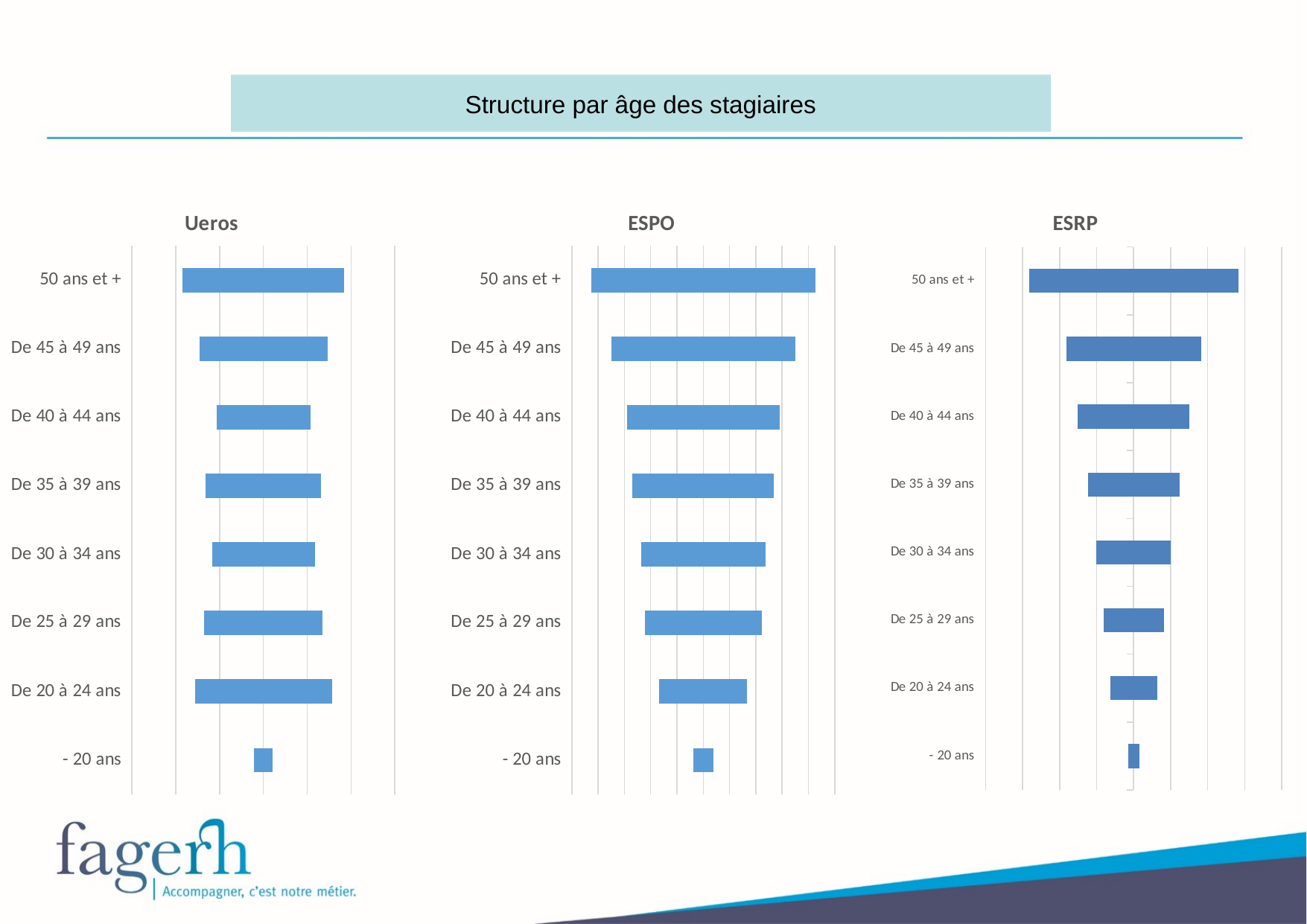
In the ESRP chart, do the bars get longer or shorter as the age group gets older? longer What kind of chart is the Ueros chart? bar chart In the ESRP chart, which age category has the longest bar? 50 ans et + In the ESRP chart, which age category has the shortest bar? - 20 ans How many age categories does the ESPO chart show? 8 In the ESPO chart, which age category has the longest bar? 50 ans et + In the ESPO chart, which age category has the shortest bar? - 20 ans In the ESRP chart, which is larger: De 20 à 24 ans or De 45 à 49 ans? De 45 à 49 ans In the Ueros chart, which is larger: 50 ans et + or De 40 à 44 ans? 50 ans et + What are the titles of the three charts on the slide, from left to right? Ueros, ESPO, ESRP In the Ueros chart, which age category has the shortest bar? - 20 ans In the Ueros chart, which age category has the longest bar? 50 ans et +